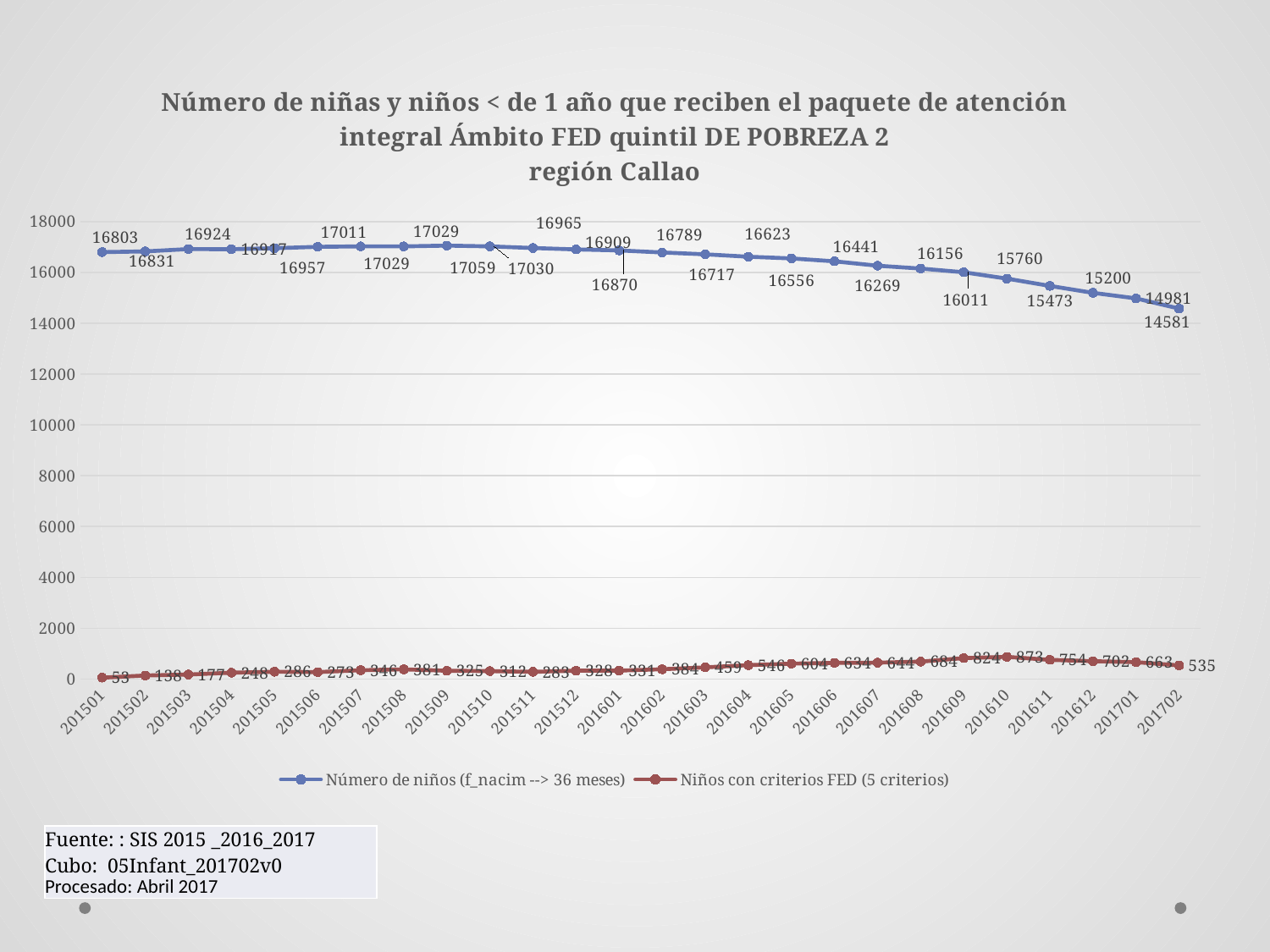
In which period does 'Niños con criterios FED (5 criterios)' reach its highest value? 201610 What is the difference between the 'Número de niños (f_nacim --> 36 meses)' values for 201501 and 201702? 2222 Does 'Número de niños (f_nacim --> 36 meses)' generally rise or fall from 201601 to 201702? fall What is the value of 'Número de niños (f_nacim --> 36 meses)' for 201702? 14581 How many series does the legend list? 2 What is the value of 'Niños con criterios FED (5 criterios)' for 201610? 873 What type of chart is shown on the slide? line chart What is the value of 'Niños con criterios FED (5 criterios)' for 201501? 53 Which is larger, the 'Niños con criterios FED (5 criterios)' value for 201609 or for 201702? 201609 How many time periods are plotted along the x axis? 26 Which region is named in the chart title? Callao In which period is 'Número de niños (f_nacim --> 36 meses)' at its lowest? 201702